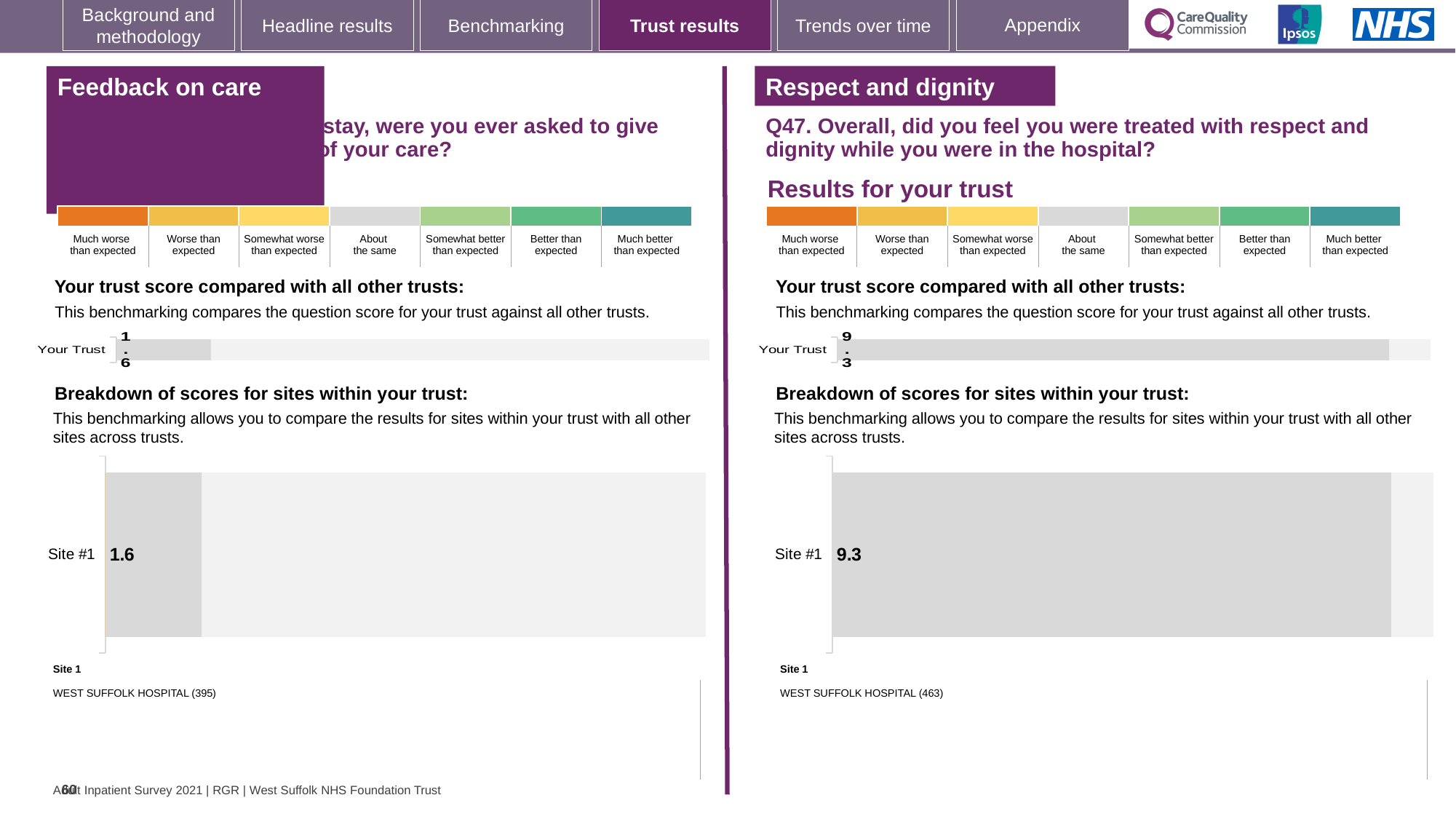
Which hospital is listed as Site 1 in the Respect and dignity section? WEST SUFFOLK HOSPITAL (463) On the Feedback on care section, what is the score shown for Site #1 in the 'Breakdown of scores for sites within your trust' chart? 1.6 On the Respect and dignity section, what is the score shown for Site #1 in the 'Breakdown of scores for sites within your trust' chart? 9.3 Which hospital is listed as Site 1 in the Feedback on care section? WEST SUFFOLK HOSPITAL (395) How many sites are shown in the 'Breakdown of scores for sites within your trust' chart in the Respect and dignity section? 1 Which question number is shown in the Respect and dignity section? Q47 Which is larger: the Site #1 score in the Feedback on care section or the Site #1 score in the Respect and dignity section? Respect and dignity How many sites are shown in the 'Breakdown of scores for sites within your trust' chart in the Feedback on care section? 1 What is the difference between the Site #1 score in the Respect and dignity section and the Site #1 score in the Feedback on care section? 7.7 On the Respect and dignity section, what is the score shown for Your Trust in the 'Your trust score compared with all other trusts' chart? 9.3 What type of chart is used to show the Site #1 score in the Respect and dignity section? Bar chart On the Feedback on care section, what is the score shown for Your Trust in the 'Your trust score compared with all other trusts' chart? 1.6